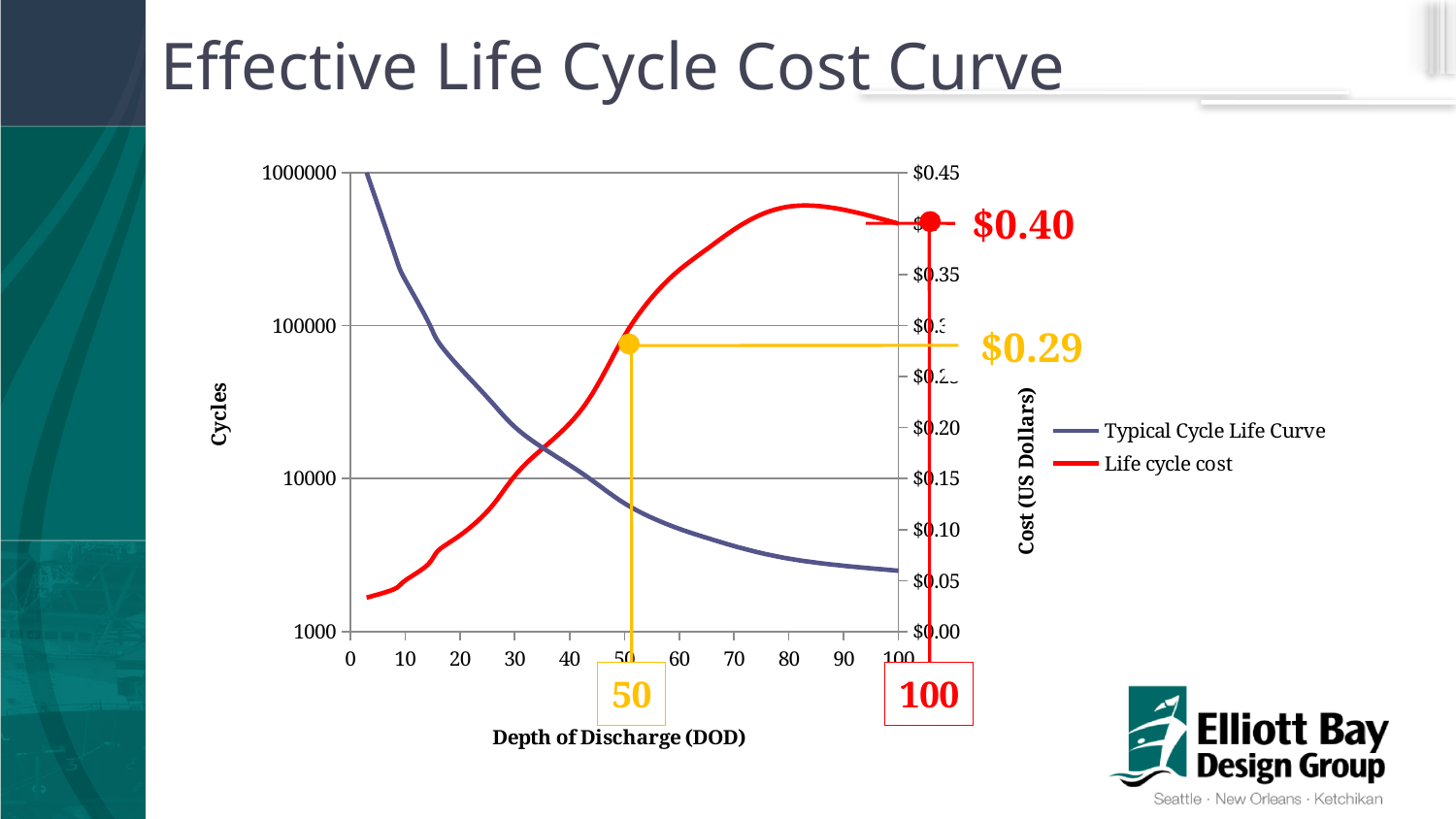
Does the Typical Cycle Life Curve rise or fall as depth of discharge increases? fall What is the title of the chart on the slide? Effective Life Cycle Cost Curve Which is larger, the life cycle cost at a depth of discharge of 50 or at 100? 100 Is the value of the Typical Cycle Life Curve at a depth of discharge of 10 greater or less than 100000 cycles? greater How many series does the legend list? 2 What is the life cycle cost at a depth of discharge of 100? $0.40 What kind of chart is shown on the slide? line chart What is the difference between the life cycle cost at a depth of discharge of 100 and at 50? $0.11 Is the life cycle cost at a depth of discharge of 70 greater or less than $0.30? greater What is the title of the x axis? Depth of Discharge (DOD) What is the life cycle cost at a depth of discharge of 50? $0.29 Does the Life cycle cost curve rise or fall between a depth of discharge of 10 and 70? rise